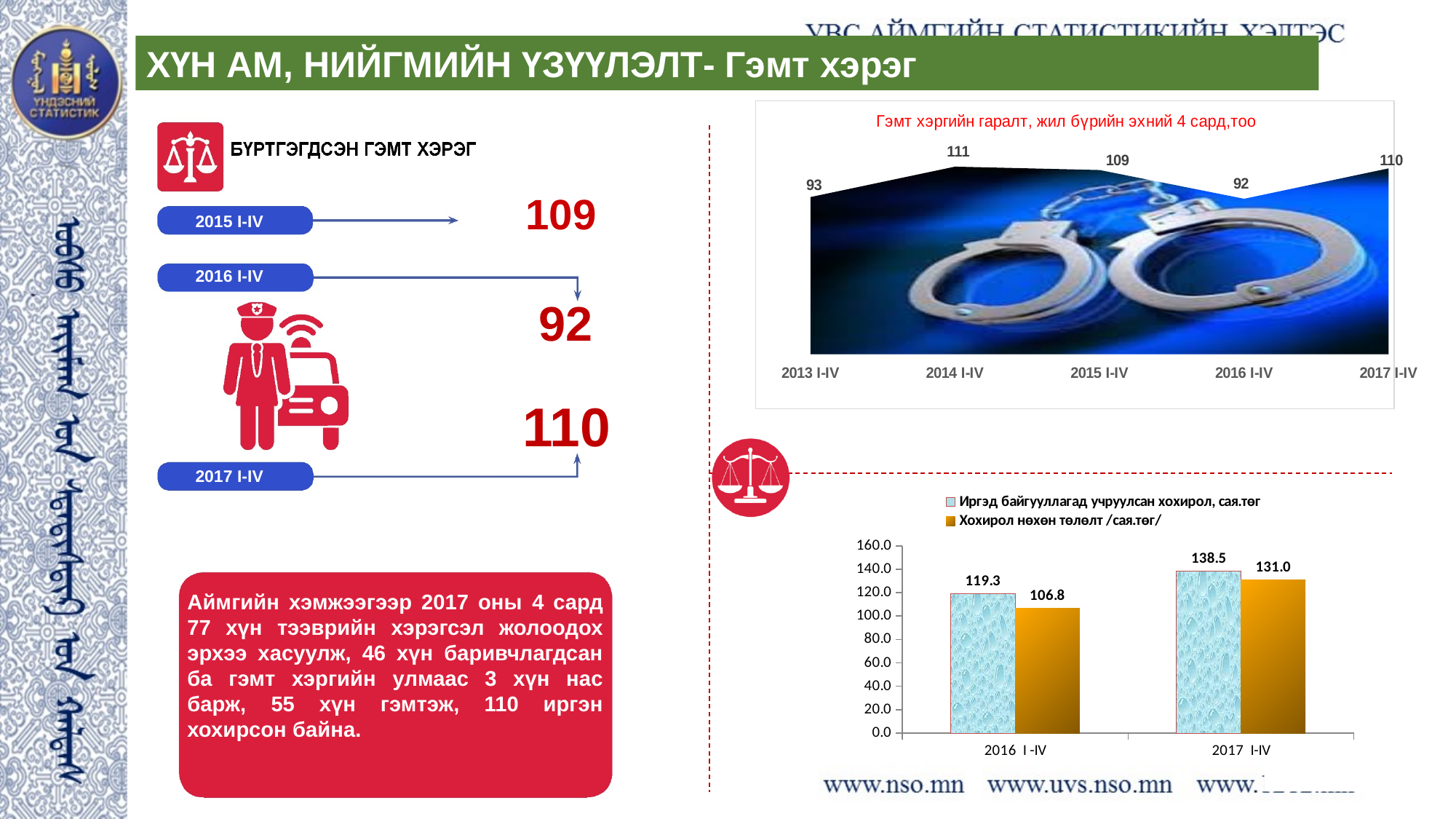
In the bottom-right bar chart, what is the value of 'Иргэд байгууллагад учруулсан хохирол, сая.төг' for 2017 I-IV? 138.5 In the chart titled 'Гэмт хэргийн гаралт, жил бүрийн эхний 4 сард,тоо', which period has the lowest value? 2016 I-IV In the bottom-right bar chart, which is larger: 'Хохирол нөхөн төлөлт /сая.төг/' for 2016 I-IV or for 2017 I-IV? 2017 I-IV How many series does the legend of the bottom-right bar chart list? 2 In the chart titled 'Гэмт хэргийн гаралт, жил бүрийн эхний 4 сард,тоо', what is the difference between the values for 2017 I-IV and 2016 I-IV? 18 In the bottom-right bar chart, what is the value of 'Хохирол нөхөн төлөлт /сая.төг/' for 2016 I-IV? 106.8 In the chart titled 'Гэмт хэргийн гаралт, жил бүрийн эхний 4 сард,тоо', which period has the highest value? 2014 I-IV In the chart titled 'Гэмт хэргийн гаралт, жил бүрийн эхний 4 сард,тоо', what is the value for 2014 I-IV? 111 In the bottom-right bar chart, what is the difference between 'Иргэд байгууллагад учруулсан хохирол, сая.төг' and 'Хохирол нөхөн төлөлт /сая.төг/' for 2017 I-IV? 7.5 What kind of chart is the bottom-right chart on the slide? Bar chart In the chart titled 'Гэмт хэргийн гаралт, жил бүрийн эхний 4 сард,тоо', what is the value for 2013 I-IV? 93 In the chart titled 'Гэмт хэргийн гаралт, жил бүрийн эхний 4 сард,тоо', how many periods are plotted? 5